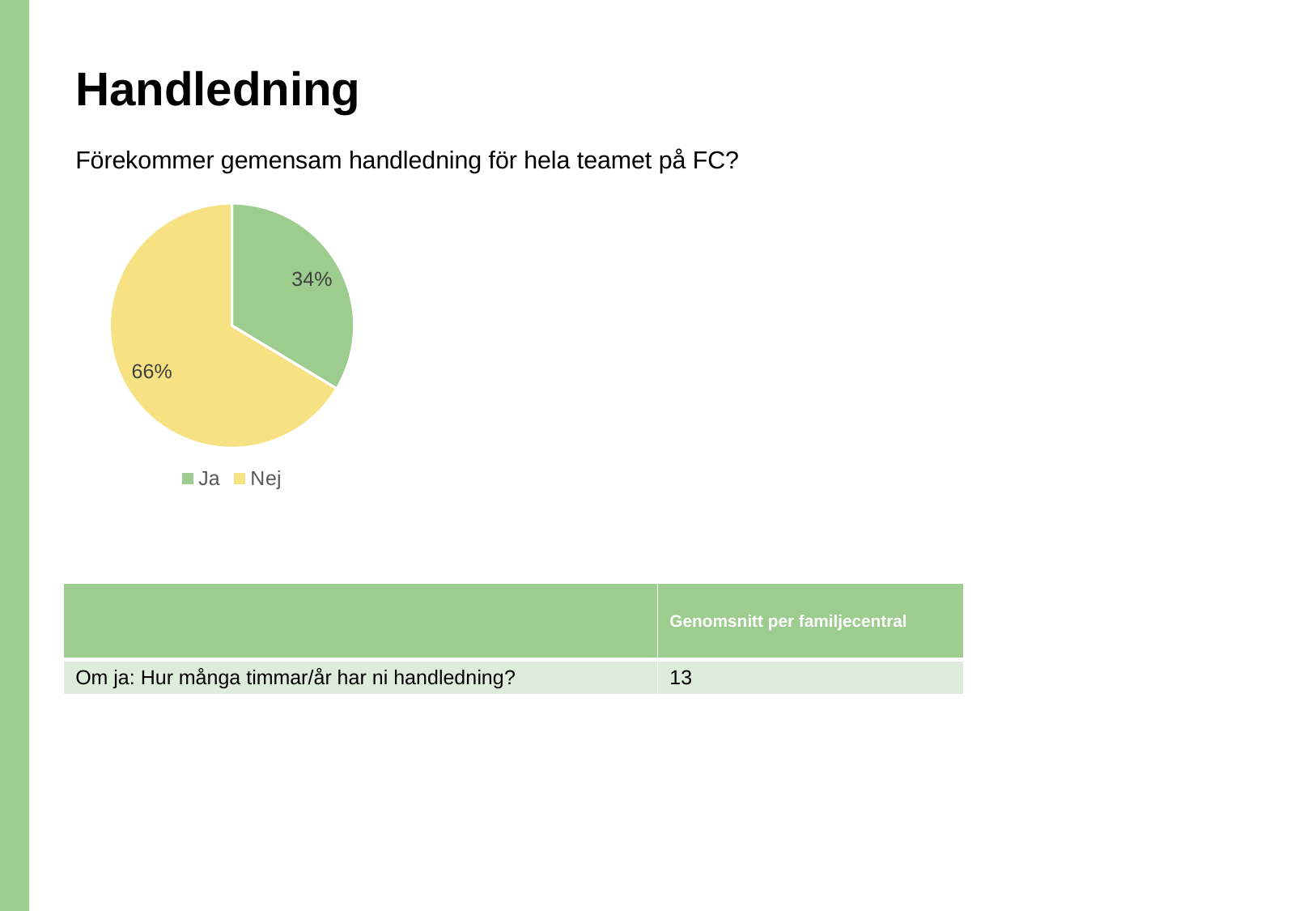
Which is larger, the share for "Ja" or the share for "Nej"? Nej What kind of chart is shown on the slide? pie chart Which slice of the pie is the smallest? Ja Which slice of the pie is the largest? Nej How many slices does the pie chart have? 2 What share of the pie does "Ja" represent? 34% What share of the pie does "Nej" represent? 66% How many entries does the legend list? 2 What colour is the "Nej" slice of the pie? yellow What is the difference in percentage points between the "Nej" share and the "Ja" share? 32 What colour is the "Ja" slice of the pie? green